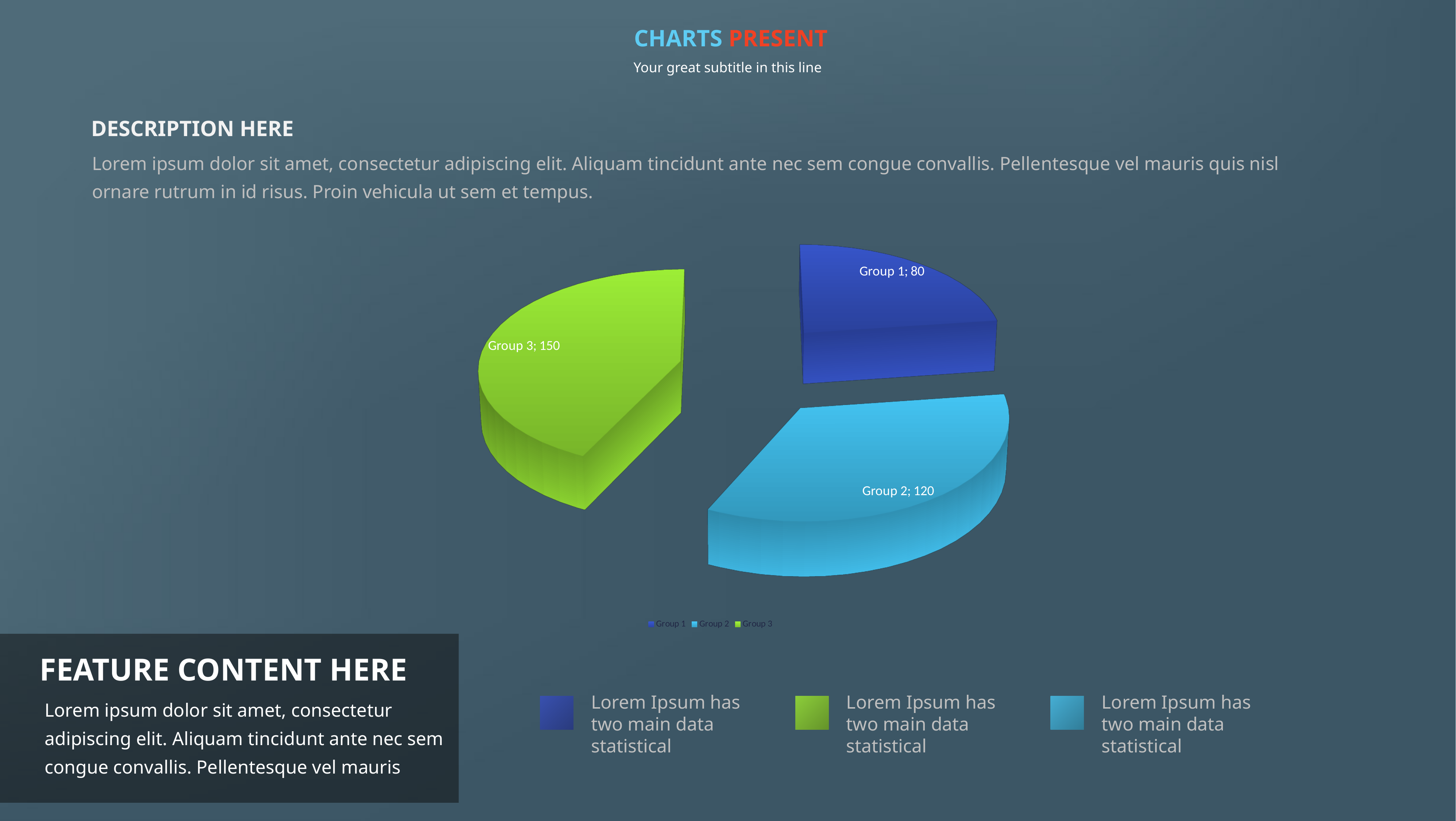
What is the difference between the values for Group 3 and Group 1? 70 How many slices does the pie chart have? 3 How many entries does the chart legend list? 3 Which group has the smallest slice in the pie chart? Group 1 What is the value for Group 3 in the pie chart? 150 What kind of chart is shown on the slide? Pie chart Which group has the largest slice in the pie chart? Group 3 What is the difference between the values for Group 2 and Group 1? 40 What is the value for Group 2 in the pie chart? 120 What is the value for Group 1 in the pie chart? 80 What share of the pie does Group 3 represent? 42.9% Which is larger, the value for Group 2 or the value for Group 3? Group 3